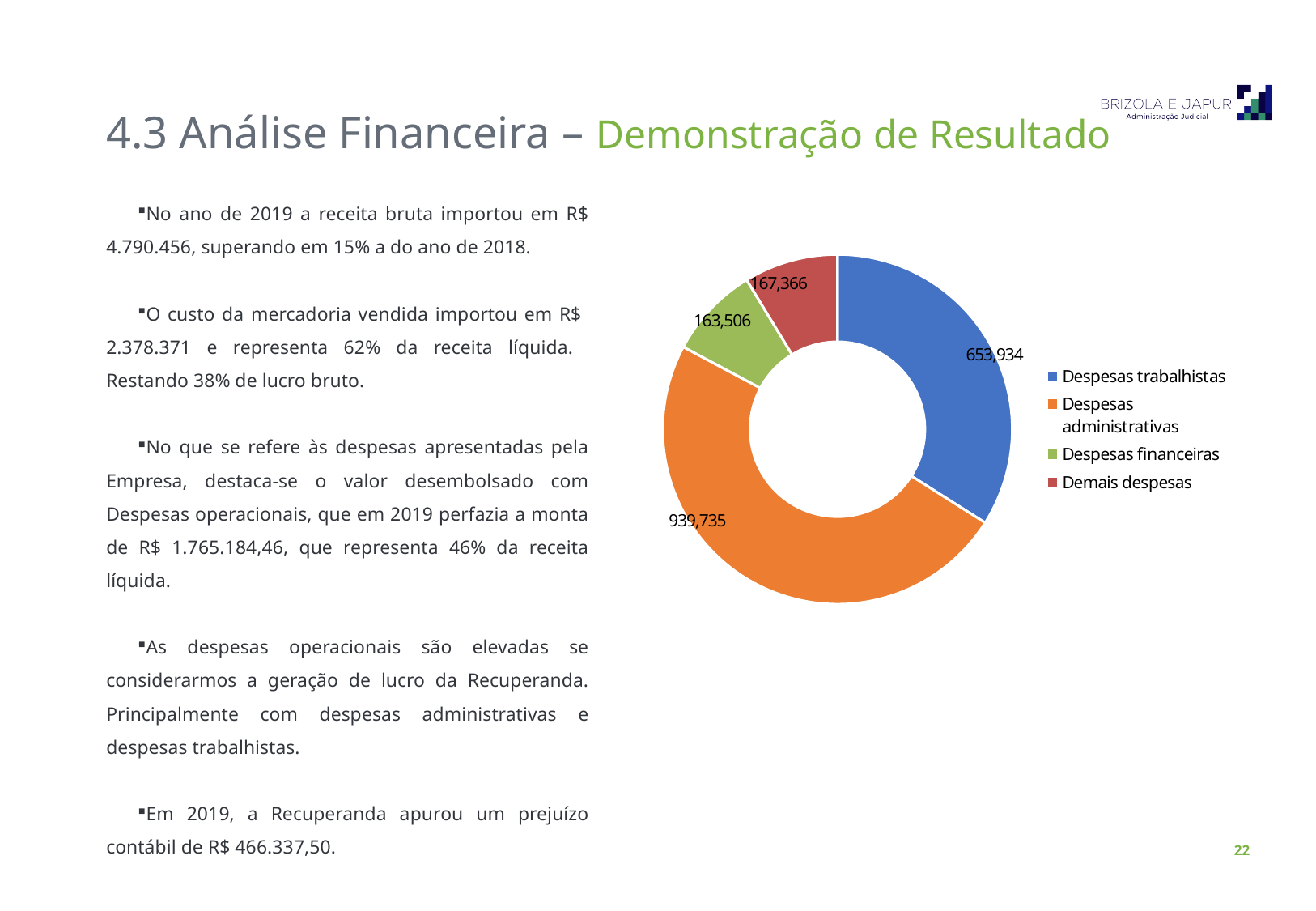
What is the value shown for Demais despesas in the chart? 167,366 How many expense categories are shown in the chart? 4 What is the difference between Demais despesas and Despesas financeiras? 3,860 What is the value shown for Despesas financeiras in the chart? 163,506 What is the value shown for Despesas administrativas in the chart? 939,735 Which is larger, Despesas trabalhistas or Despesas administrativas? Despesas administrativas What is the value shown for Despesas trabalhistas in the chart? 653,934 Which expense category has the smallest value in the chart? Despesas financeiras Which colour represents Despesas financeiras in the chart? Green What kind of chart is shown on the slide? Doughnut chart What is the difference between Despesas administrativas and Despesas trabalhistas? 285,801 Which expense category has the largest value in the chart? Despesas administrativas